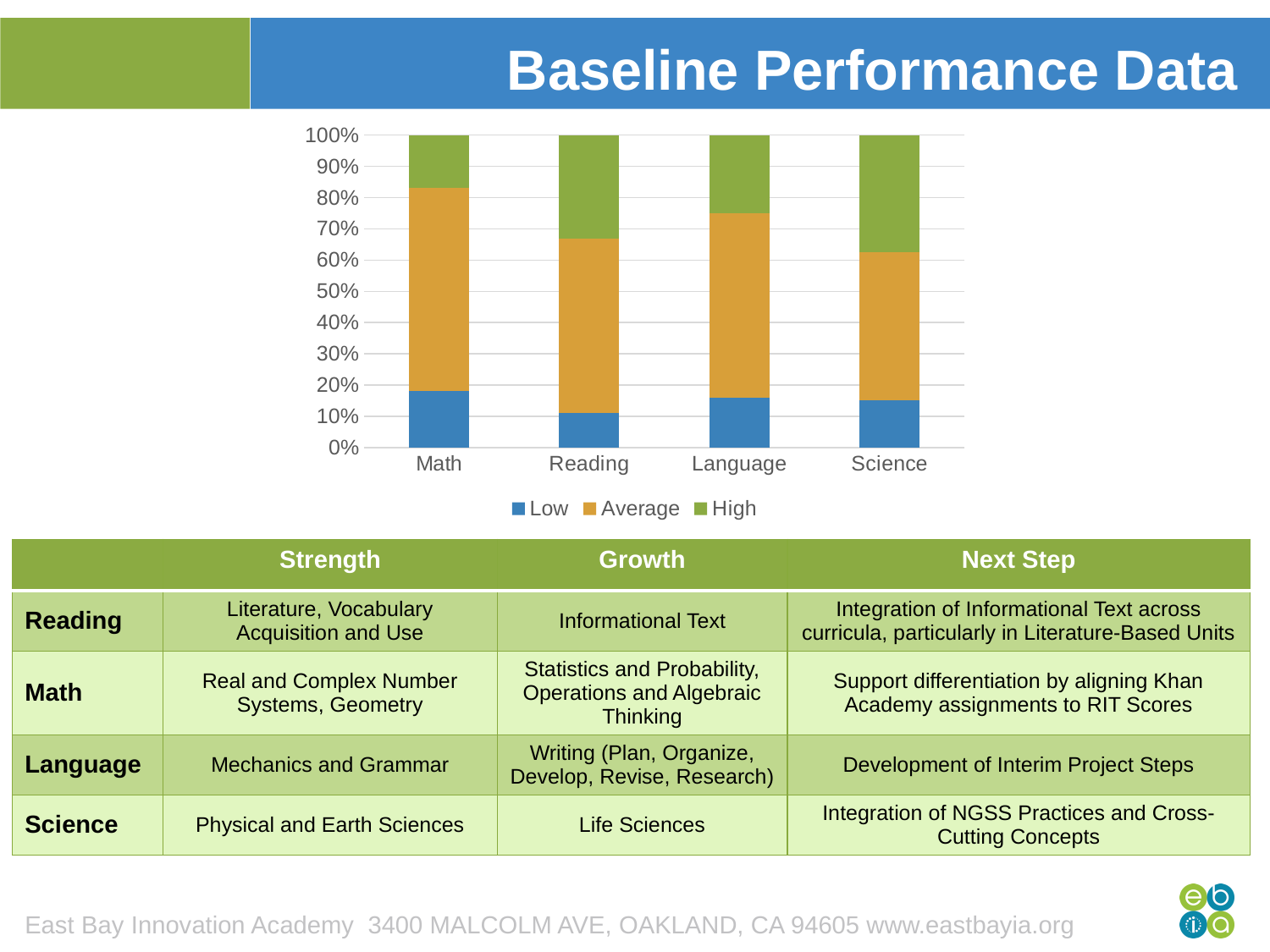
Is the top of the Average segment for Reading greater or less than 70%? less What kind of chart is shown on the slide? Stacked bar chart Which is larger, the High segment for Science or the High segment for Math? Science What is the title of the slide containing the chart? Baseline Performance Data What is the total of the stacked bar for Language? 100% Is the Low value for Reading greater or less than 20%? less Which subject has the smallest High segment? Math What are the three series named in the chart legend? Low, Average, High How many subject categories are shown on the x axis of the chart? 4 Is the Low value for Math greater or less than 20%? less How many series does the chart legend list? 3